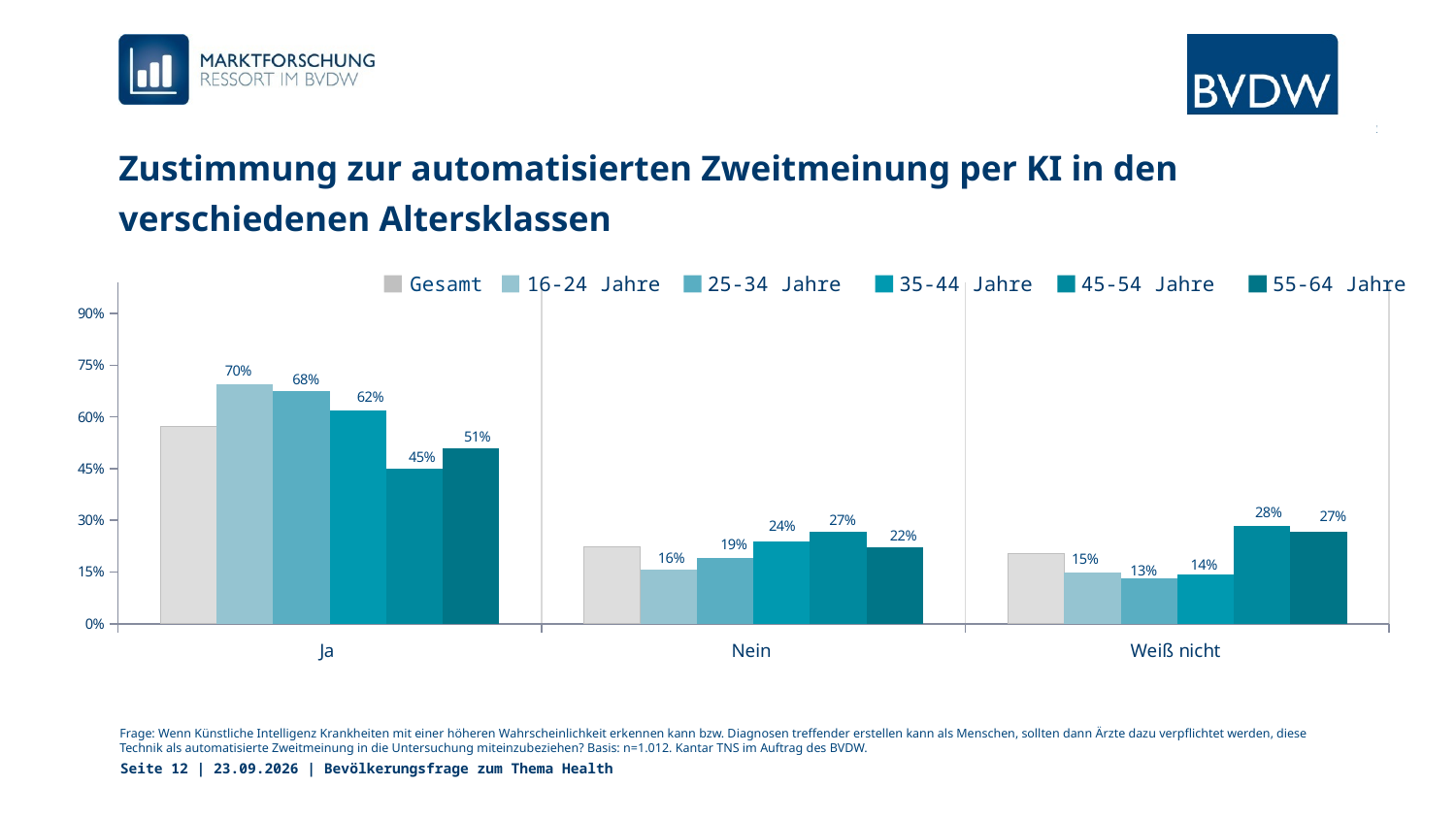
What kind of chart is shown on the slide? Bar chart Is the value for Gesamt in the Ja category greater or less than 45%? greater In the Weiß nicht category, which is larger: the value for 45-54 Jahre or the value for 35-44 Jahre? 45-54 Jahre How many series does the legend list? 6 What is the value for 25-34 Jahre in the Weiß nicht category? 13% What is the title of the chart? Zustimmung zur automatisierten Zweitmeinung per KI in den verschiedenen Altersklassen Which age group has the highest value in the Ja category? 16-24 Jahre What is the value for 45-54 Jahre in the Nein category? 27% Which age group has the lowest value in the Nein category? 16-24 Jahre What is the difference between the 16-24 Jahre and 55-64 Jahre values in the Ja category? 19% What is the value for 16-24 Jahre in the Ja category? 70% How many categories are shown on the x axis? 3